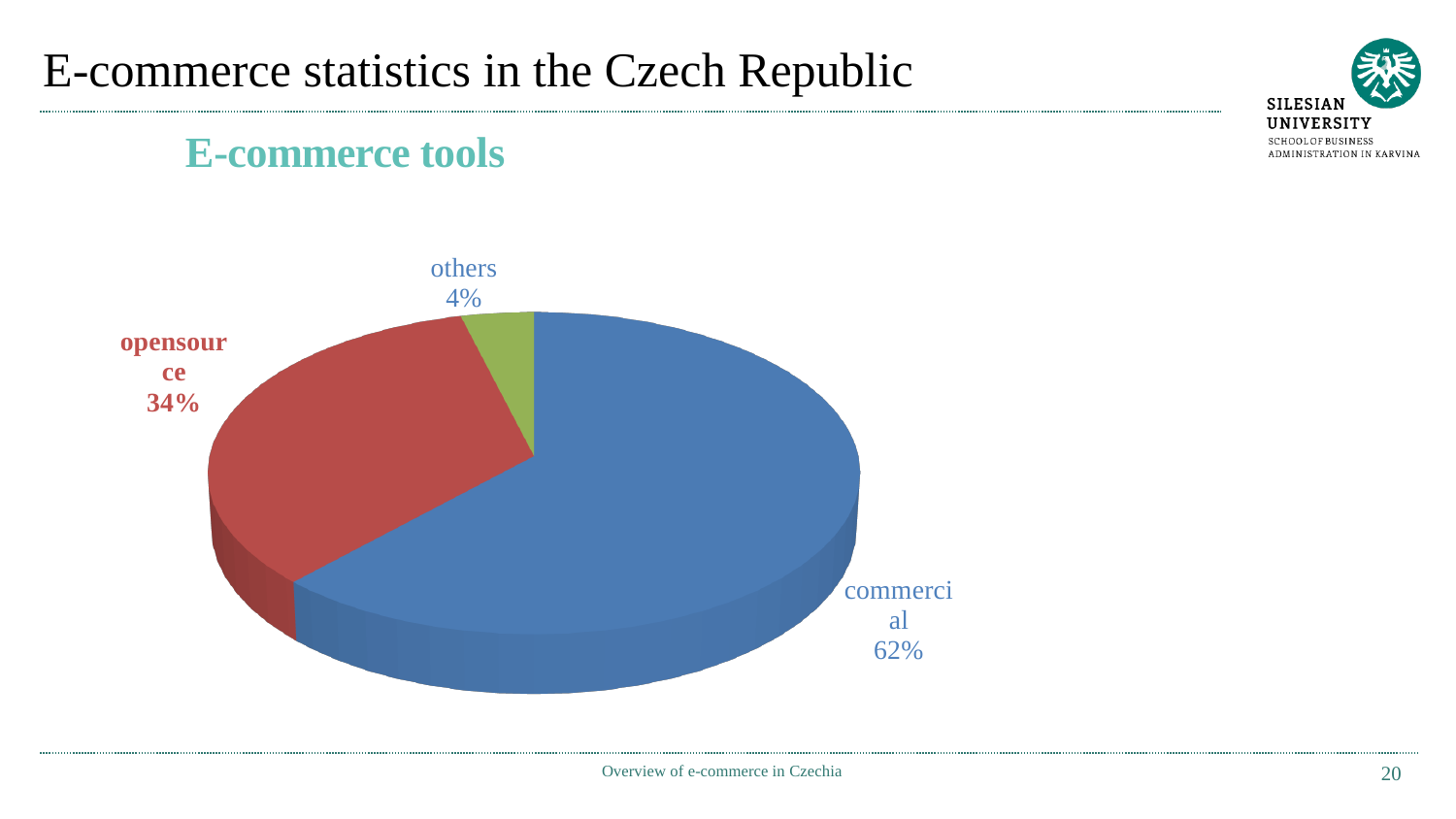
What share of the pie does the commercial slice represent? 62% What share of the pie does the opensource slice represent? 34% How many slices does the pie chart have? 3 What is the difference in percentage points between the opensource and others shares? 30 Which category has the smallest share of the pie? others What is the title of the chart? E-commerce tools What kind of chart is shown on the slide? pie chart What is the difference in percentage points between the commercial and opensource shares? 28 Which is larger, the commercial share or the opensource share? commercial What share of the pie does the others slice represent? 4% Which category has the largest share of the pie? commercial What colour is the commercial slice? blue